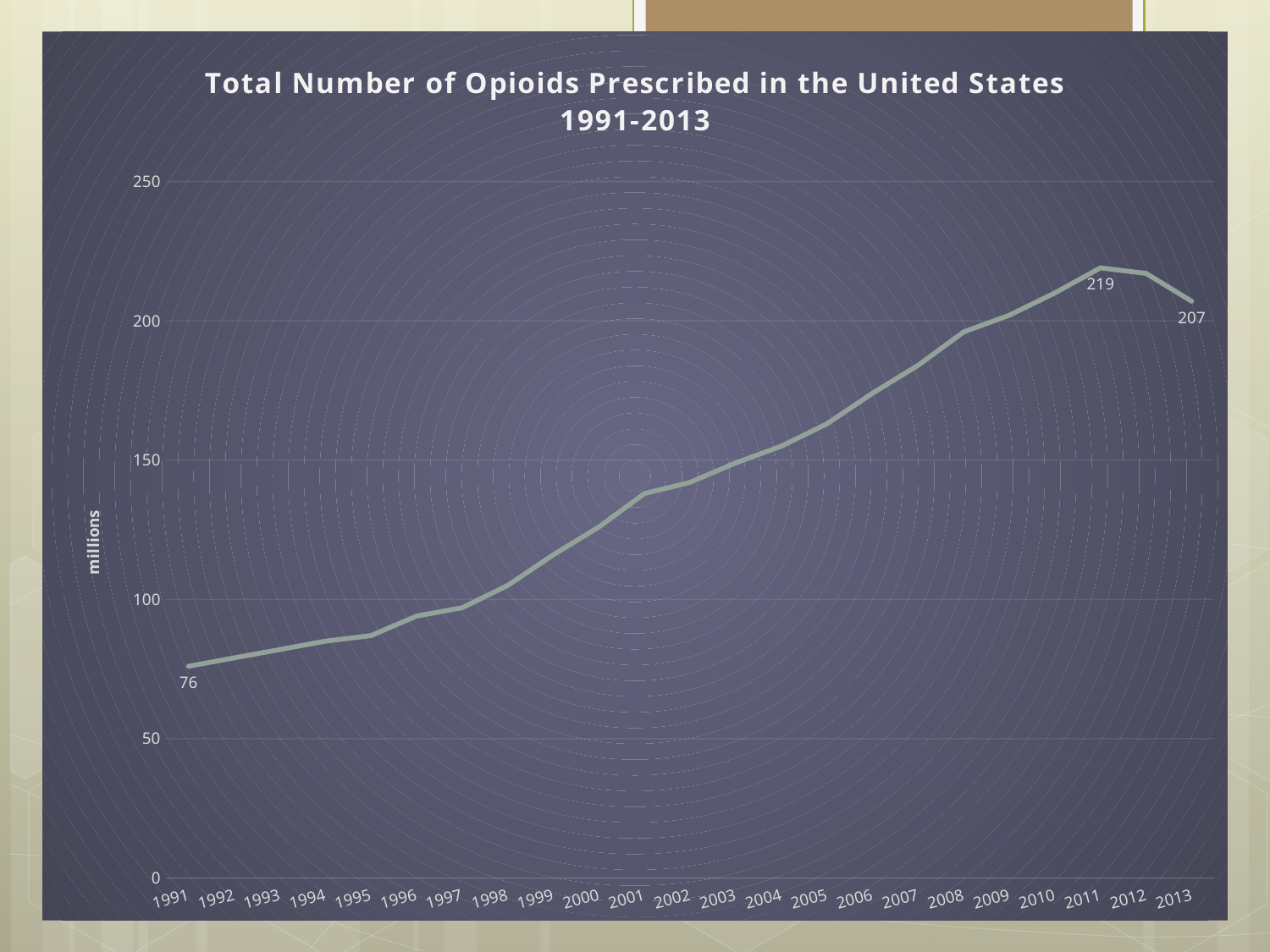
What kind of chart is this? line chart What is the value for 1991? 76 Which year has the lowest value? 1991 What is the difference between the values for 2011 and 1991? 143 What is the difference between the values for 2011 and 2013? 12 How many years are plotted on the x axis? 23 Is the value for 2005 greater or less than 150? greater What is the value for 2013? 207 Is the value for 1996 greater or less than 100? less Is the value for 2001 greater or less than 150? less Which is larger, the value for 2011 or the value for 2013? 2011 What is the value for 2011? 219